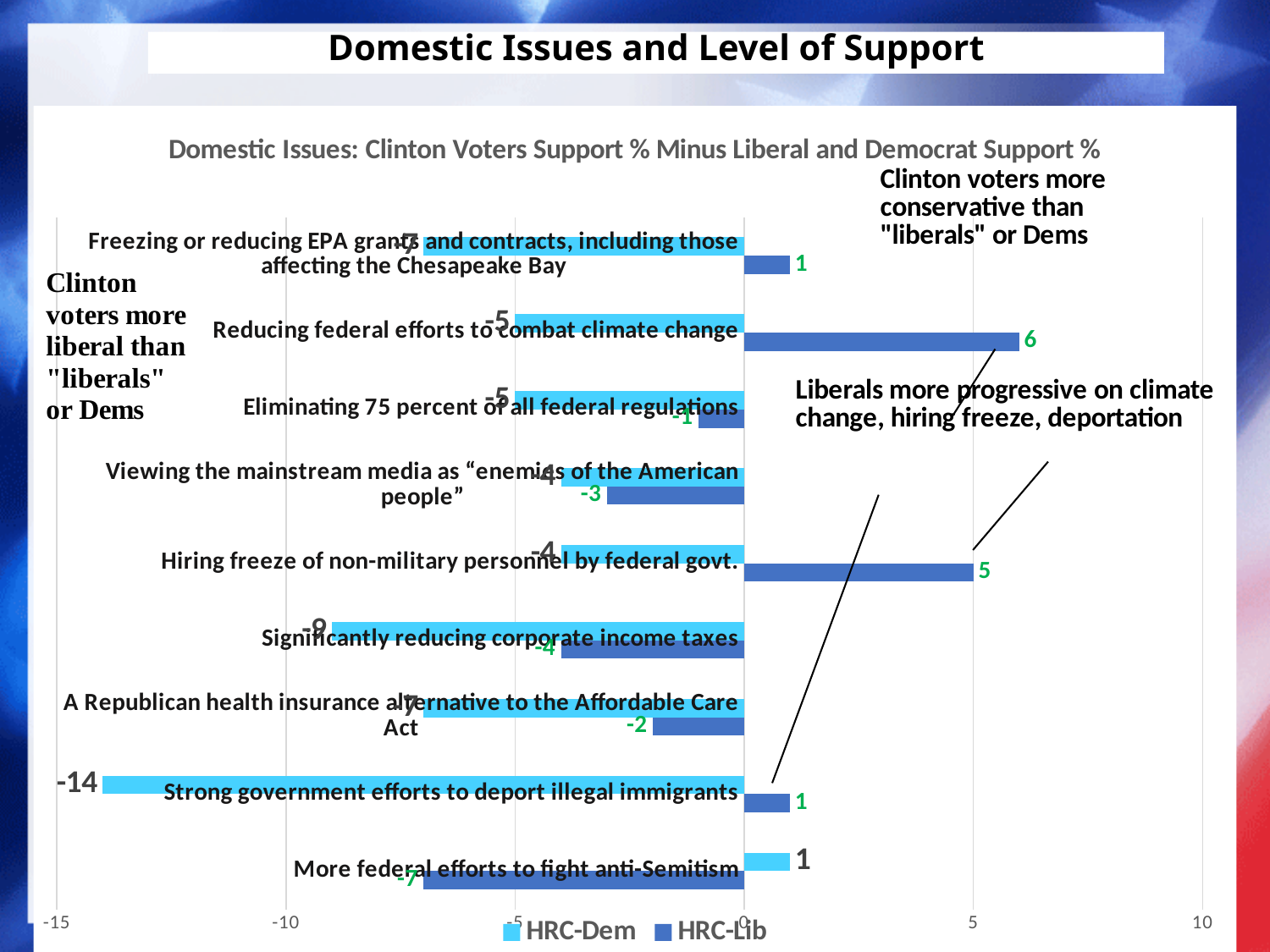
Which category has the highest HRC-Lib value? Reducing federal efforts to combat climate change Which has the larger HRC-Lib value: "Reducing federal efforts to combat climate change" or "Hiring freeze of non-military personnel by federal govt."? Reducing federal efforts to combat climate change What is the HRC-Lib value for "Hiring freeze of non-military personnel by federal govt."? 5 For "Significantly reducing corporate income taxes", what is the difference between the HRC-Lib value (-4) and the HRC-Dem value (-9)? 5 Which category has the lowest HRC-Dem value? Strong government efforts to deport illegal immigrants What is the HRC-Lib value for "Reducing federal efforts to combat climate change"? 6 What is the HRC-Dem value for "Strong government efforts to deport illegal immigrants"? -14 How many series does the legend list? 2 What is the HRC-Lib value for "More federal efforts to fight anti-Semitism"? -7 What are the two series names shown in the legend? HRC-Dem and HRC-Lib What kind of chart is shown on the slide? Bar chart How many domestic issue categories are plotted on the chart? 9